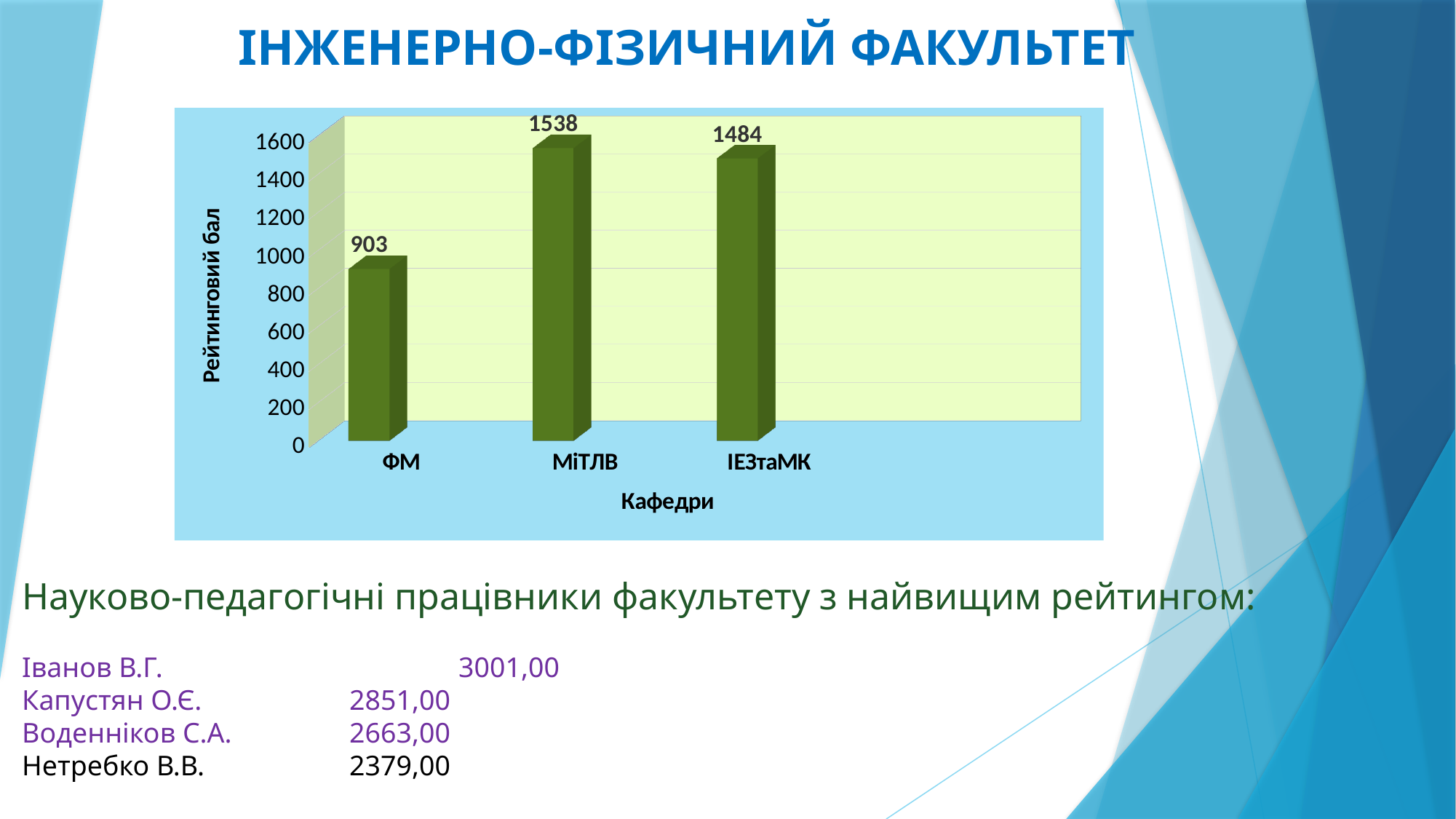
Which department (кафедра) has the highest rating score? МіТЛВ Which department has the lowest rating score? ФМ Which has a higher rating score, ФМ or ІЕЗтаМК? ІЕЗтаМК What is the rating score for МіТЛВ? 1538 Is the value for ФМ greater or less than 1000? less What kind of chart is shown on the slide? bar chart What is the rating score (Рейтинговий бал) for ФМ? 903 How many departments are shown on the chart? 3 What is the difference between the rating scores of МіТЛВ and ІЕЗтаМК? 54 What is the difference between the rating scores of МіТЛВ and ФМ? 635 What is the label of the horizontal axis of the chart? Кафедри What is the rating score for ІЕЗтаМК? 1484